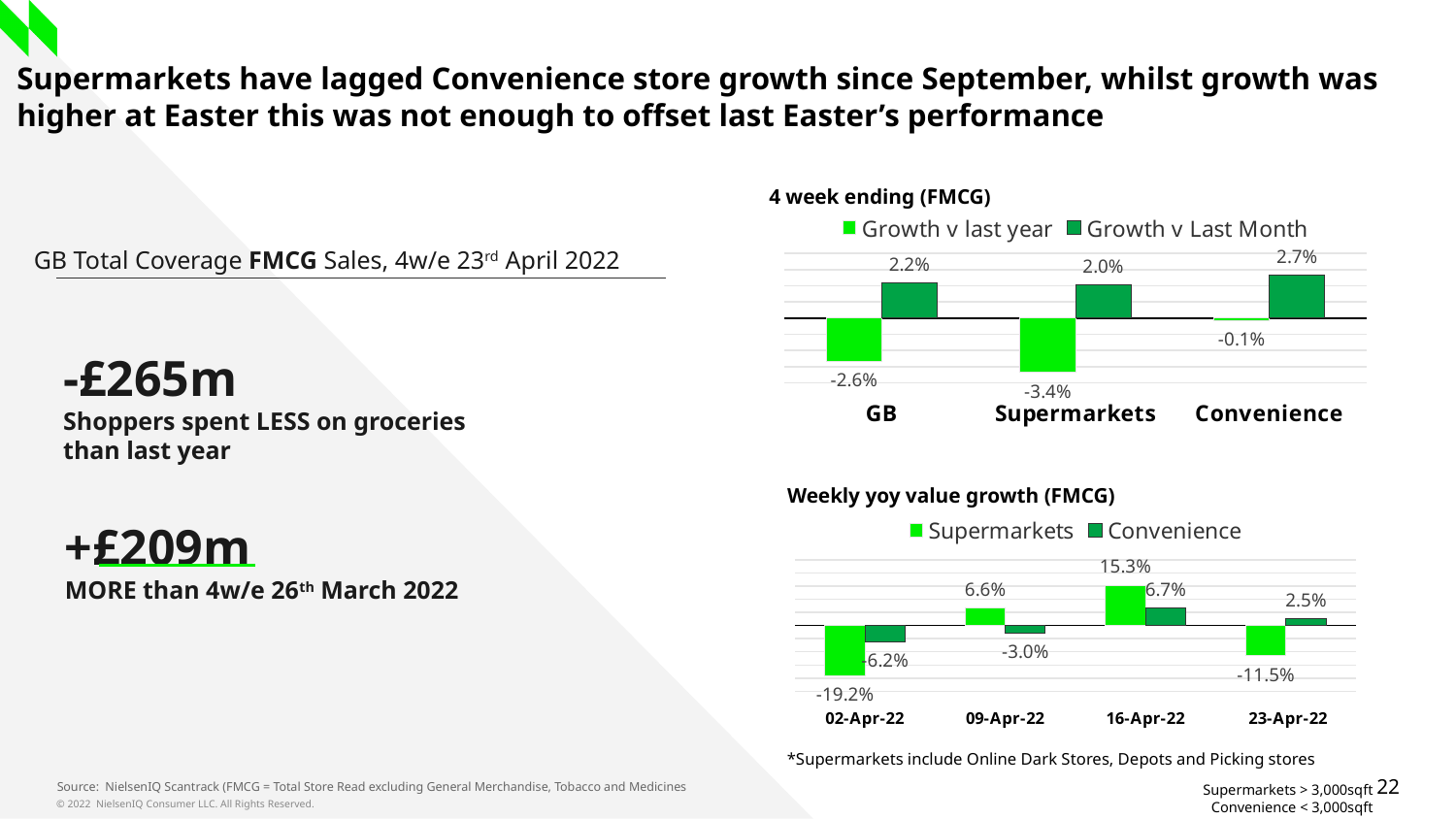
In the '4 week ending (FMCG)' chart, what is the difference between the Growth v Last Month values for Convenience and Supermarkets? 0.7% In the '4 week ending (FMCG)' chart, which category has the lowest Growth v last year value? Supermarkets In the '4 week ending (FMCG)' chart, what is the Growth v last year value for Supermarkets? -3.4% In the '4 week ending (FMCG)' chart, how many categories are shown on the x axis? 3 In the 'Weekly yoy value growth (FMCG)' chart, which is larger for 23-Apr-22: the Supermarkets value or the Convenience value? Convenience In the 'Weekly yoy value growth (FMCG)' chart, what is the Supermarkets value for 16-Apr-22? 15.3% In the '4 week ending (FMCG)' chart, what is the Growth v Last Month value for Convenience? 2.7% In the '4 week ending (FMCG)' chart, how many series does the legend list? 2 In the 'Weekly yoy value growth (FMCG)' chart, what is the difference between the Supermarkets and Convenience values for 02-Apr-22? 13.0% What kind of chart is the 'Weekly yoy value growth (FMCG)' chart? Bar chart In the 'Weekly yoy value growth (FMCG)' chart, what is the Convenience value for 09-Apr-22? -3.0% In the 'Weekly yoy value growth (FMCG)' chart, which week has the lowest Supermarkets value? 02-Apr-22